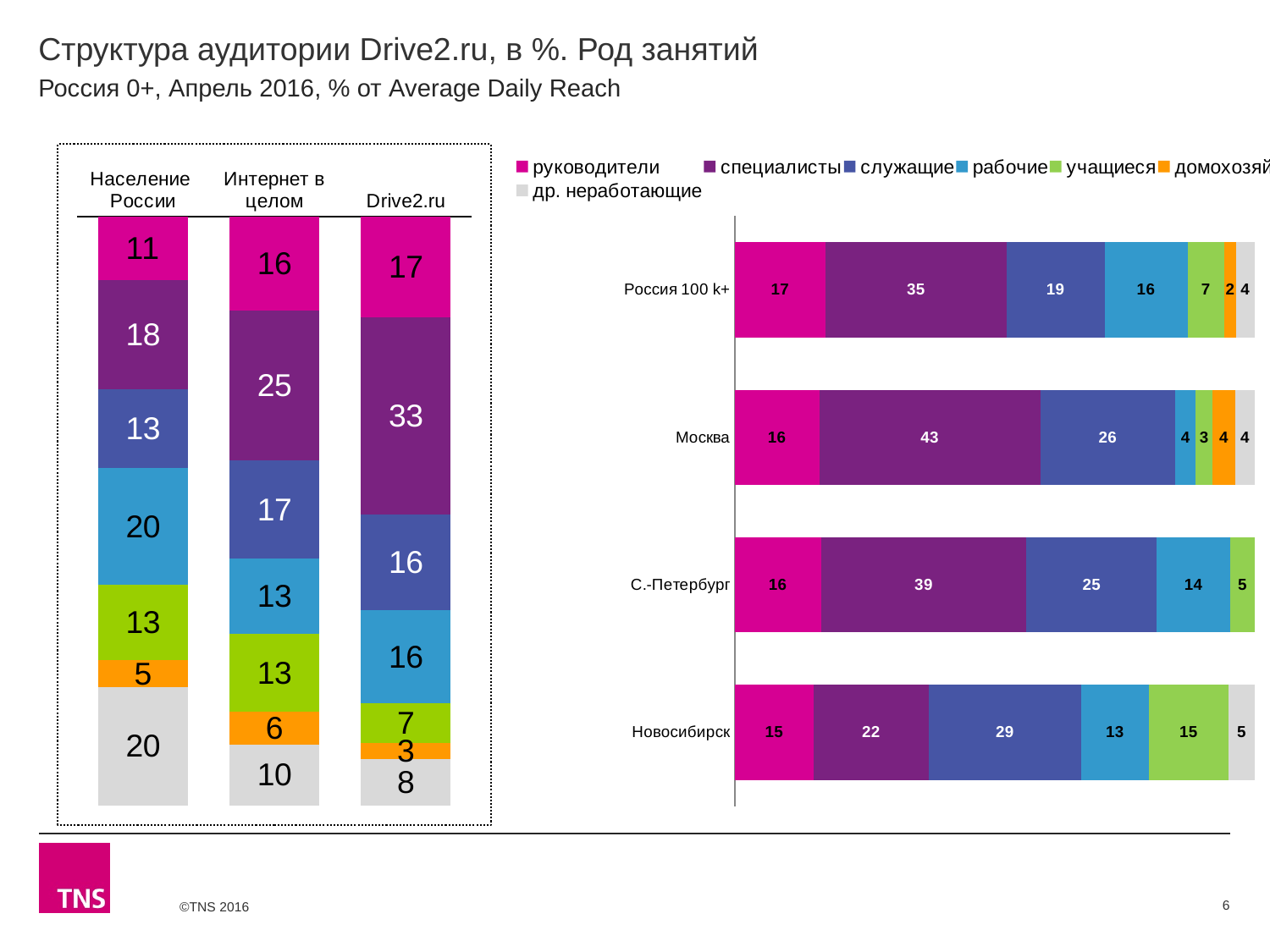
On the right chart, which is larger: the рабочие (light blue) value for Россия 100 k+ or for Москва? Россия 100 k+ On the right chart, what is the value for служащие (dark blue segment) for Новосибирск? 29 On the right chart, which city or region has the highest value for специалисты (purple segment)? Москва On the left chart, what is the value for специалисты (purple segment) in the Drive2.ru bar? 33 On the left chart, what is the value for рабочие (light blue segment) in the Население России bar? 20 What kind of chart is the right chart? Stacked horizontal bar chart How many series does the legend of the right chart list? 7 On the right chart, which city or region has the lowest value for специалисты (purple segment)? Новосибирск How many bars does the left chart show? 3 On the left chart, what is the difference between the специалисты value for Drive2.ru and for Население России? 15 On the left chart, what is the total of the Drive2.ru stacked bar? 100 On the right chart, what is the value for специалисты (purple segment) for Москва? 43